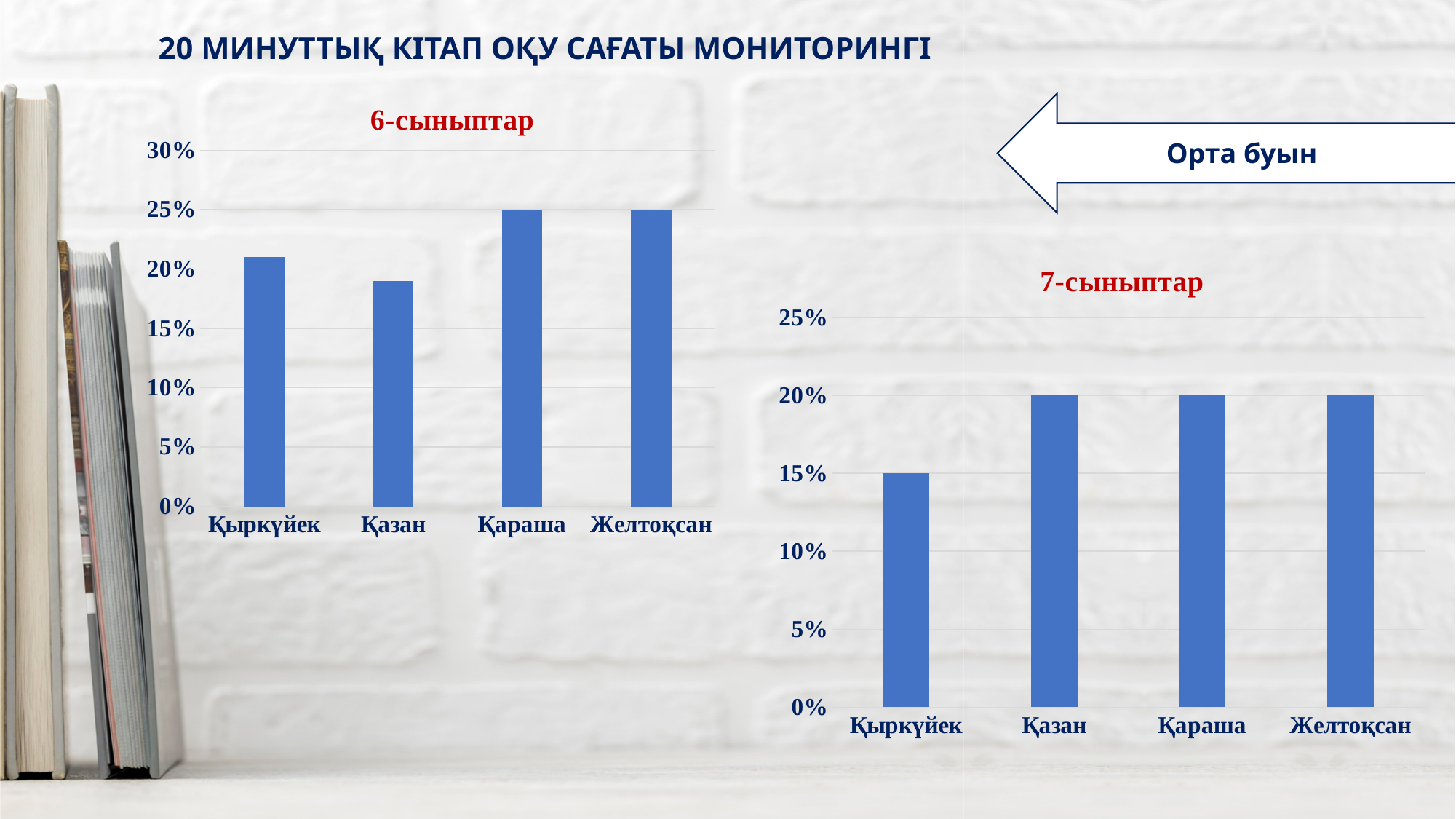
In the "6-сыныптар" chart, what is the value for Қараша? 25% In the "7-сыныптар" chart, what is the value for Қыркүйек? 15% What is the title of the chart on the right side of the slide? 7-сыныптар In the "7-сыныптар" chart, what is the difference between the values for Қазан and Қыркүйек? 5% In the "6-сыныптар" chart, is the value for Қазан greater or less than 20%? less In the "6-сыныптар" chart, which month has the lowest value? Қазан In the "7-сыныптар" chart, which month has the lowest value? Қыркүйек In the "6-сыныптар" chart, how many months are shown on the x axis? 4 What kind of chart is the "6-сыныптар" chart on the left? bar chart In the "7-сыныптар" chart, what is the value for Қазан? 20% In the "6-сыныптар" chart, is the value for Қыркүйек greater or less than 20%? greater In the "6-сыныптар" chart, which is larger, the value for Қыркүйек or the value for Қазан? Қыркүйек